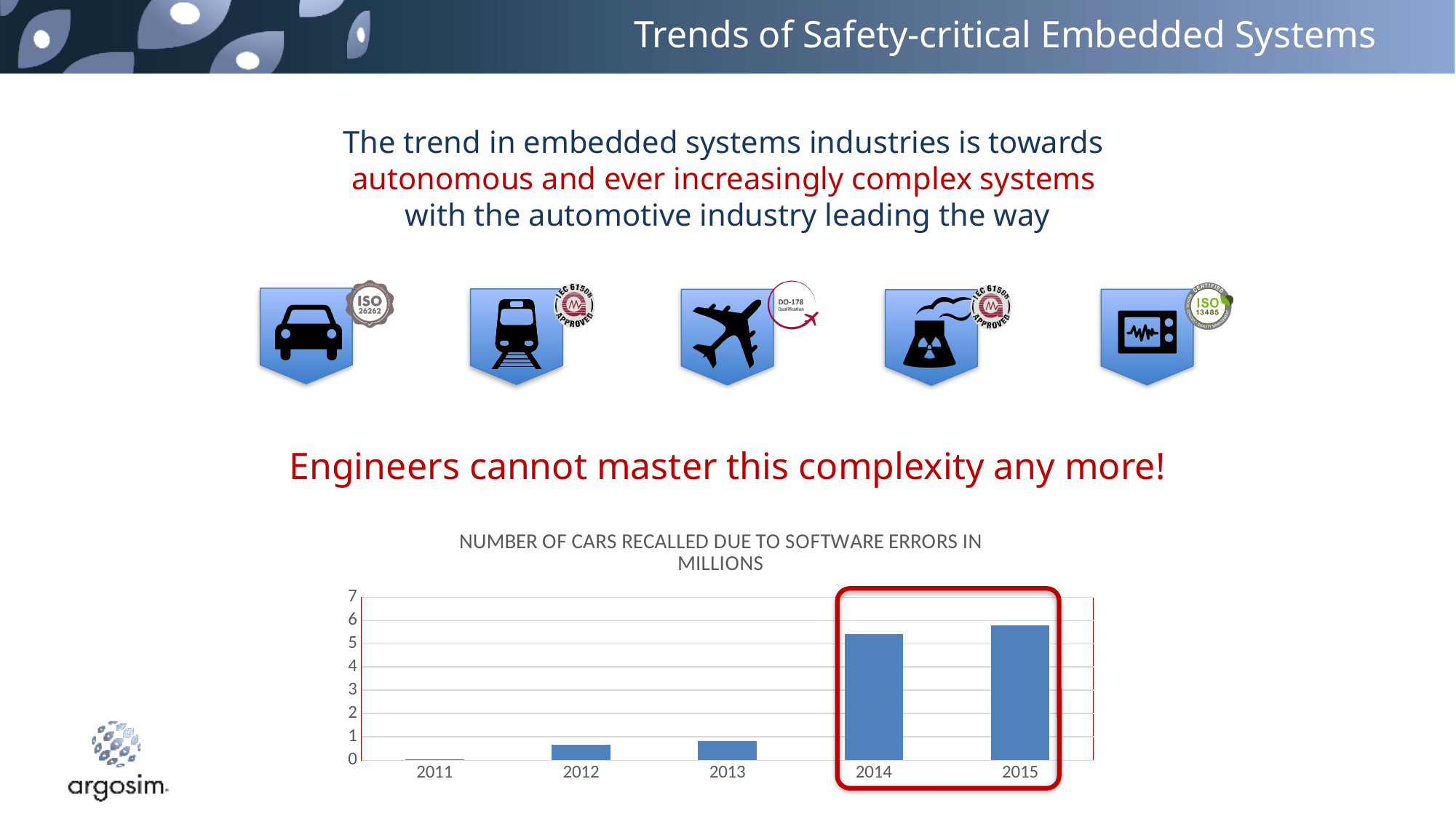
Is the value for 2013 greater or less than 1? less What kind of chart is shown on the slide? bar chart Which year has the lowest number of cars recalled due to software errors? 2011 Is the value for 2012 greater or less than 1? less How many years are shown on the x axis of the chart? 5 Is the value for 2014 greater or less than 5? greater What is the title of the chart? NUMBER OF CARS RECALLED DUE TO SOFTWARE ERRORS IN MILLIONS Which years are highlighted with a red box on the chart? 2014 and 2015 Do the values rise or fall from 2011 to 2015? rise Which year has the highest number of cars recalled due to software errors? 2015 Which year has a larger value, 2014 or 2013? 2014